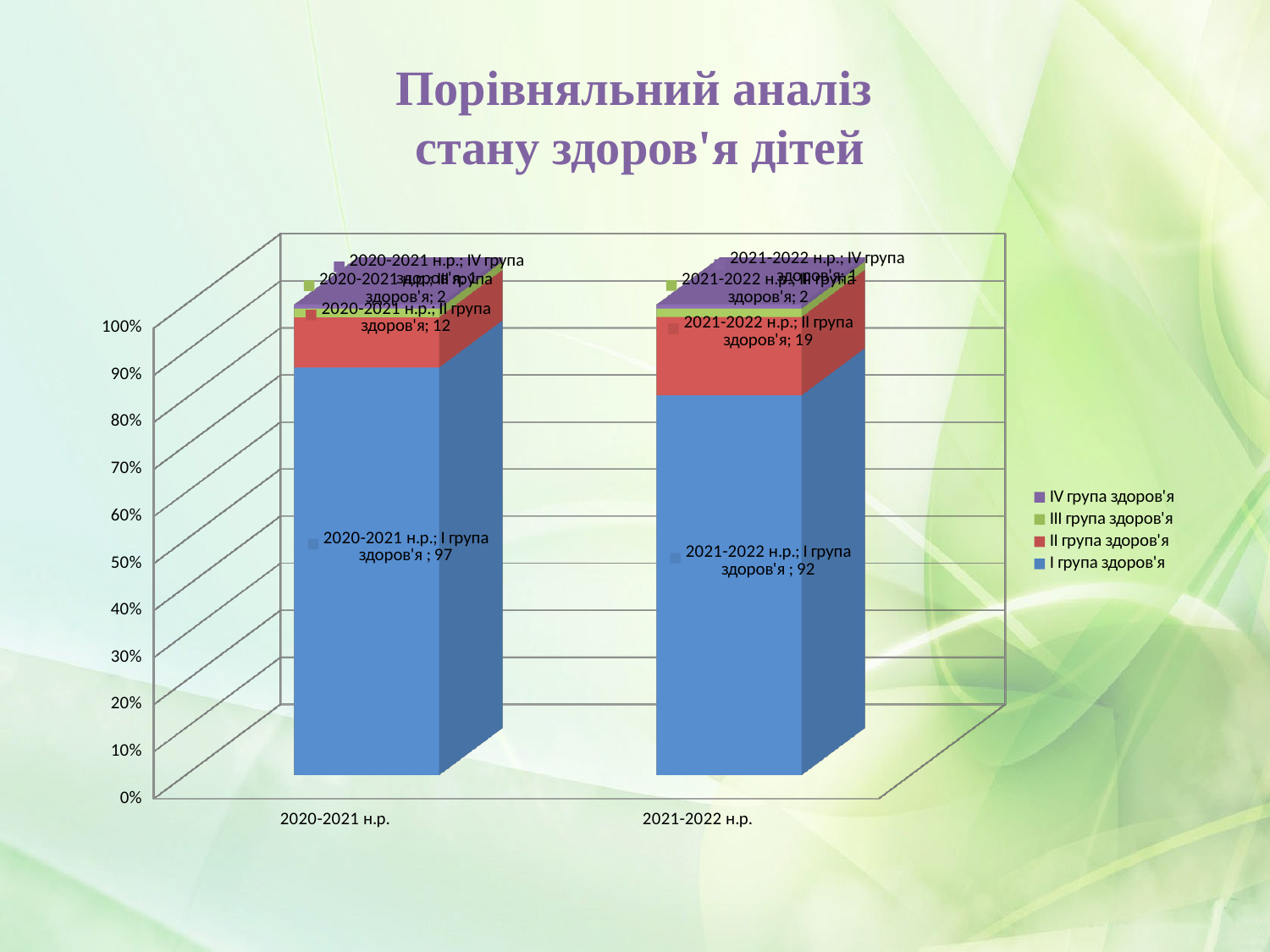
What kind of chart is shown on the slide? Stacked bar chart Which year has the larger value for I група здоров'я, 2020-2021 н.р. or 2021-2022 н.р.? 2020-2021 н.р. What is the value for I група здоров'я in 2021-2022 н.р.? 92 What is the value for II група здоров'я in 2020-2021 н.р.? 12 What is the value for III група здоров'я in 2021-2022 н.р.? 2 How many series does the legend list? 4 What is the difference between the II група здоров'я values for 2021-2022 н.р. and 2020-2021 н.р.? 7 What is the difference between the I група здоров'я values for 2020-2021 н.р. and 2021-2022 н.р.? 5 What is the value for I група здоров'я in 2020-2021 н.р.? 97 What is the value for II група здоров'я in 2021-2022 н.р.? 19 What is the title of the slide? Порівняльний аналіз стану здоров'я дітей How many categories (school years) are shown on the x axis? 2